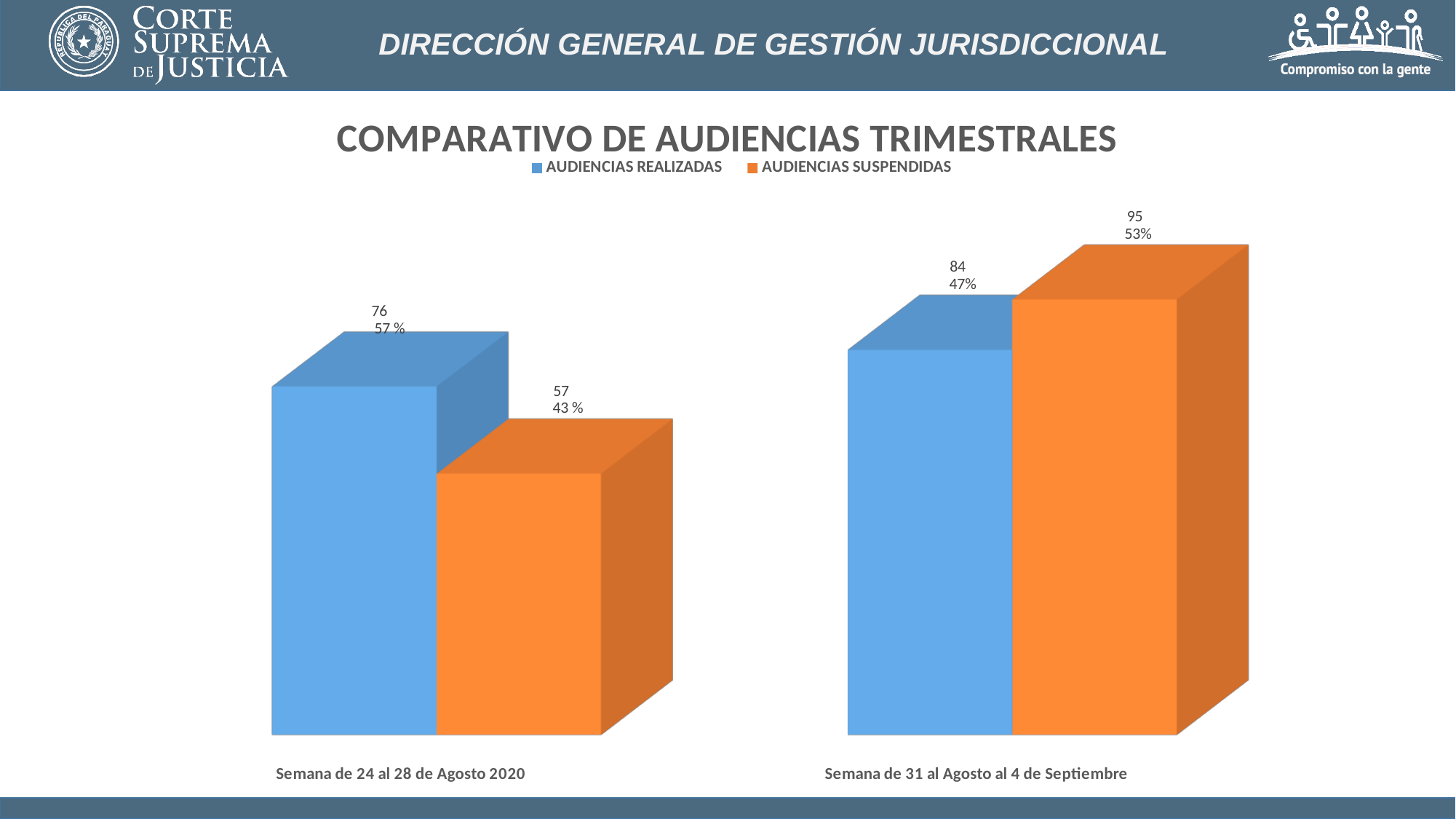
Which series has the higher value for Semana de 31 al Agosto al 4 de Septiembre? AUDIENCIAS SUSPENDIDAS What is the value of AUDIENCIAS REALIZADAS for Semana de 31 al Agosto al 4 de Septiembre? 84 How many categories (weeks) are shown on the x axis? 2 What is the value of AUDIENCIAS REALIZADAS for Semana de 24 al 28 de Agosto 2020? 76 What is the value of AUDIENCIAS SUSPENDIDAS for Semana de 31 al Agosto al 4 de Septiembre? 95 Which series has the higher value for Semana de 24 al 28 de Agosto 2020? AUDIENCIAS REALIZADAS How many series does the legend list? 2 What is the difference between AUDIENCIAS REALIZADAS and AUDIENCIAS SUSPENDIDAS for Semana de 24 al 28 de Agosto 2020? 19 By how much did AUDIENCIAS SUSPENDIDAS increase from Semana de 24 al 28 de Agosto 2020 to Semana de 31 al Agosto al 4 de Septiembre? 38 What percentage is shown for AUDIENCIAS SUSPENDIDAS in Semana de 31 al Agosto al 4 de Septiembre? 53% What is the value of AUDIENCIAS SUSPENDIDAS for Semana de 24 al 28 de Agosto 2020? 57 What type of chart is shown on the slide? Bar chart